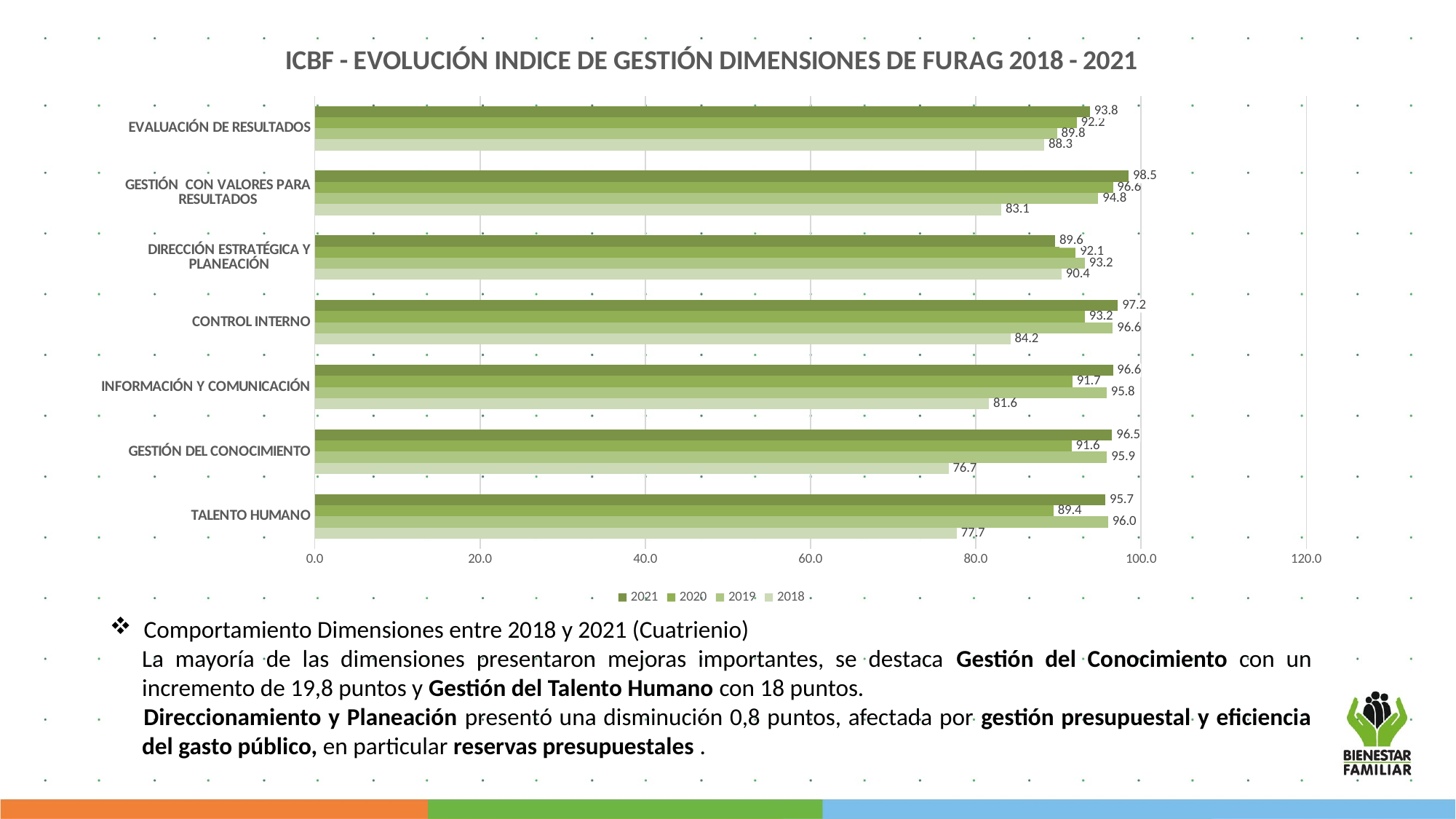
How many series does the legend list? 4 What is the 2019 value for TALENTO HUMANO? 96.0 What is the 2021 value for GESTIÓN CON VALORES PARA RESULTADOS? 98.5 What is the title of the chart? ICBF - EVOLUCIÓN INDICE DE GESTIÓN DIMENSIONES DE FURAG 2018 - 2021 Is the 2018 value for INFORMACIÓN Y COMUNICACIÓN greater or less than 80.0? greater What is the difference between the 2021 and 2018 values for GESTIÓN DEL CONOCIMIENTO? 19.8 What kind of chart is shown on the slide? Bar chart What is the 2018 value for GESTIÓN DEL CONOCIMIENTO? 76.7 Which is larger for DIRECCIÓN ESTRATÉGICA Y PLANEACIÓN, the 2021 value or the 2019 value? 2019 How many dimensions (categories) are plotted on the chart? 7 Which dimension has the highest 2021 value? GESTIÓN CON VALORES PARA RESULTADOS Which dimension has the lowest 2018 value? GESTIÓN DEL CONOCIMIENTO